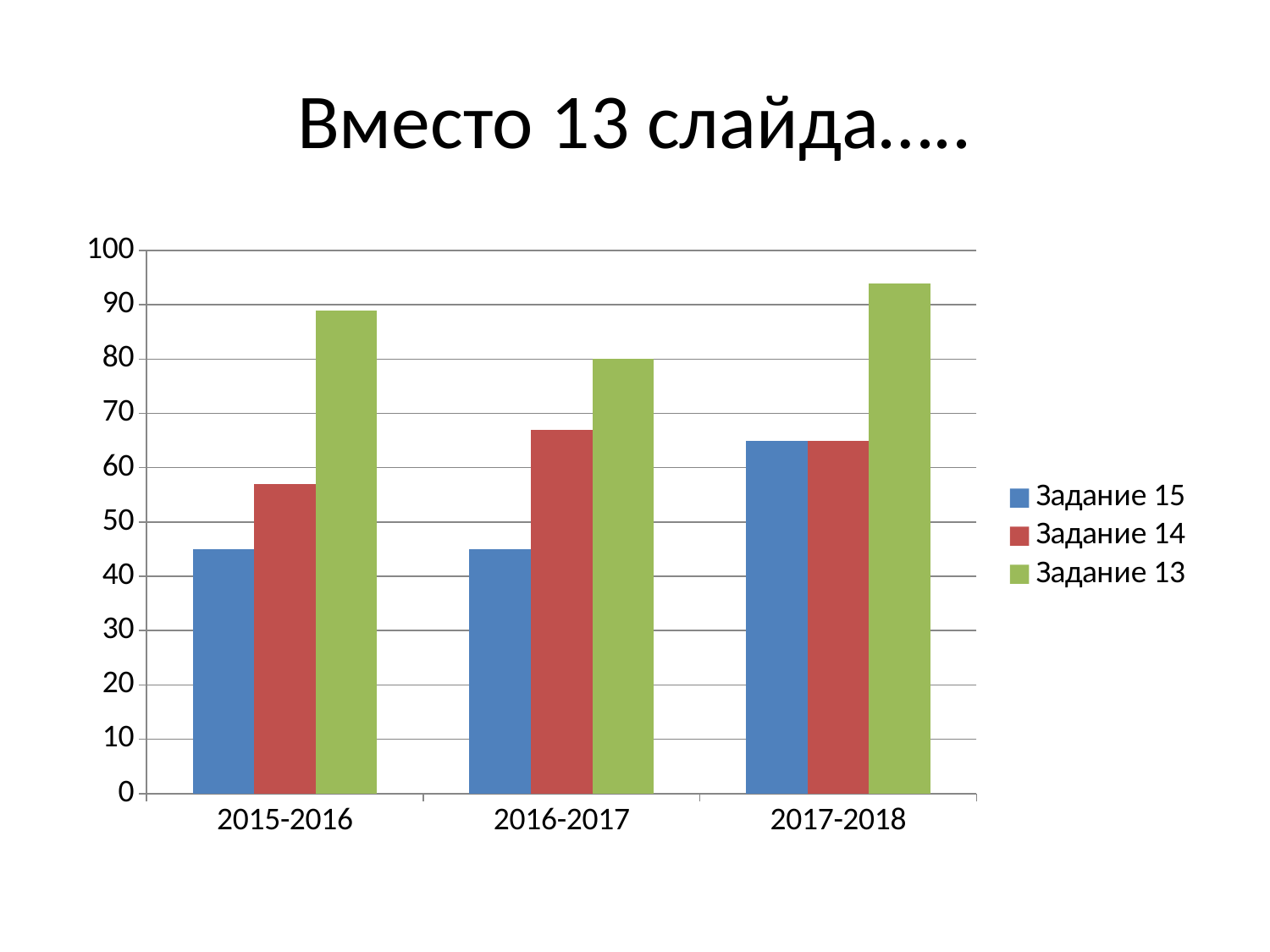
What kind of chart is shown on the slide? bar chart What colour are the bars for Задание 13? green Which is larger in 2016-2017: Задание 14 or Задание 15? Задание 14 How many categories are shown on the x axis? 3 Is the value for Задание 13 in 2017-2018 greater or less than 90? greater Is the value for Задание 14 in 2016-2017 greater or less than 60? greater Is the value for Задание 15 in 2015-2016 greater or less than 50? less Which series has the lowest value in 2015-2016? Задание 15 How many series does the legend list? 3 Which series has the highest value in 2017-2018? Задание 13 In which category does Задание 13 reach its highest value? 2017-2018 Does the value for Задание 15 rise or fall from 2016-2017 to 2017-2018? rise